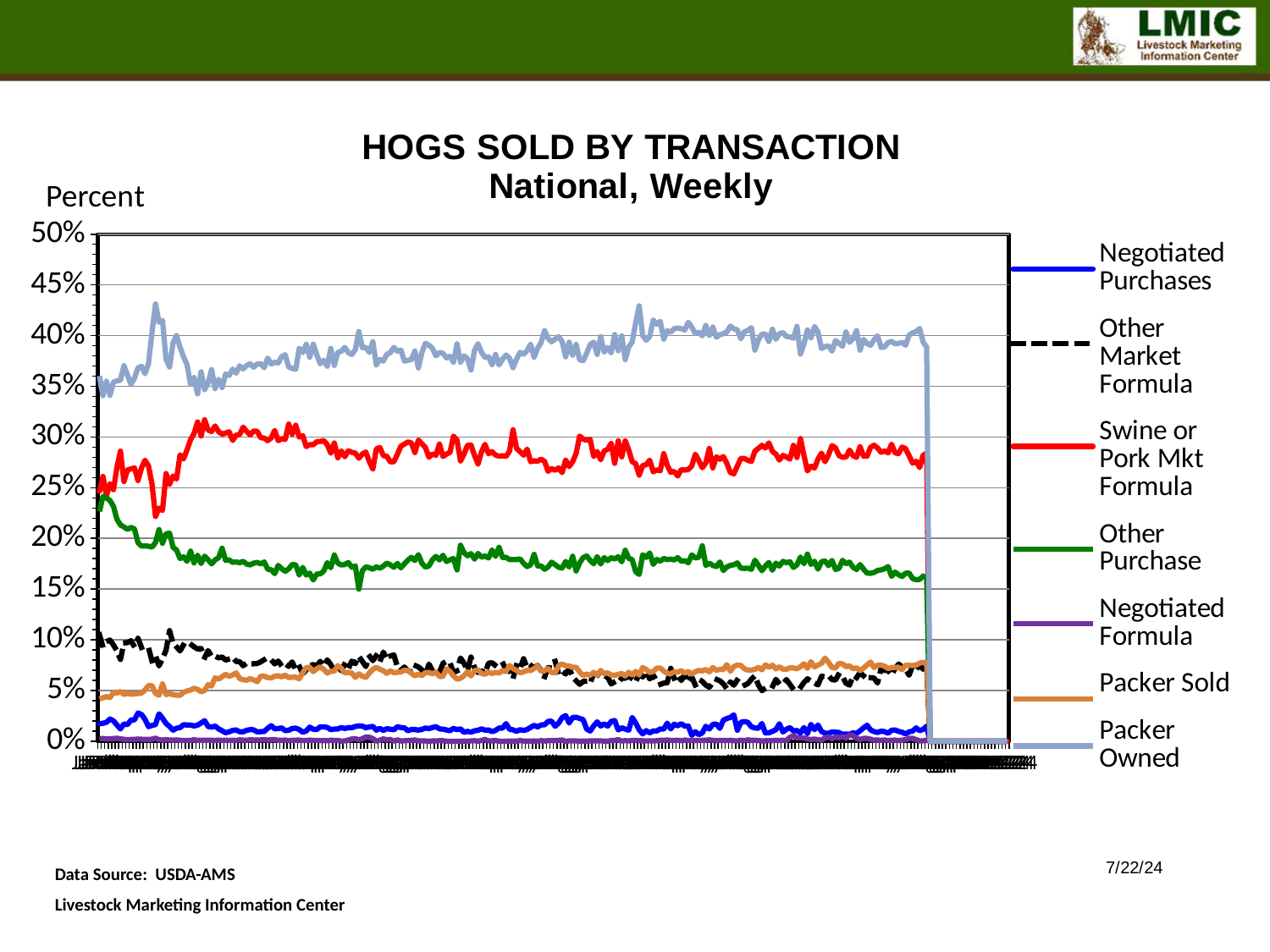
What is the title of the chart? HOGS SOLD BY TRANSACTION National, Weekly Which series has the highest values across the period shown? Packer Owned Which series has the lowest values across the period shown? Negotiated Formula Is the value for Packer Owned at the end of the period greater or less than 30%? greater What kind of chart is shown on the slide? line chart Does the Packer Sold series rise or fall from the start to the end of the period? rise Which series is larger at the end of the period, Packer Sold or Negotiated Purchases? Packer Sold Is the value for Other Purchase at the end of the period greater or less than 20%? less How many series does the legend list? 7 Which series is larger throughout the period, Swine or Pork Mkt Formula or Other Purchase? Swine or Pork Mkt Formula What is the label on the vertical axis? Percent Does the Other Market Formula series rise or fall from the start to the end of the period? fall